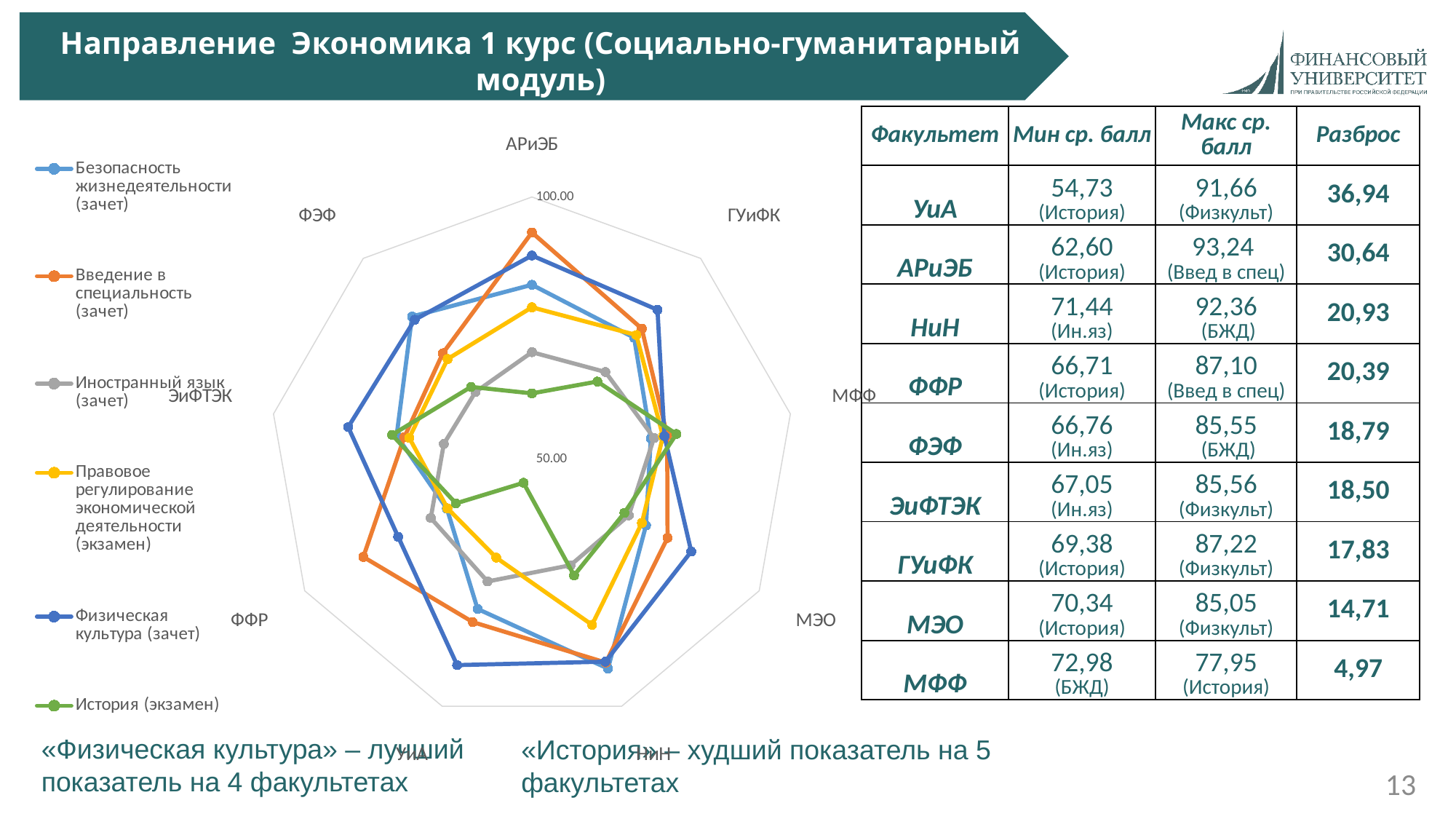
Which series has the lowest value for УиА? История (экзамен) How many faculty categories are plotted around the radar chart? 9 Which series has the lowest value for АРиЭБ? История (экзамен) Which series has the highest value for ЭиФТЭК? Физическая культура (зачет) What kind of chart is shown on the slide? Radar chart For МЭО, which is larger: Физическая культура (зачет) or История (экзамен)? Физическая культура (зачет) Which series has the highest value for УиА? Физическая культура (зачет) Which series has the lowest value for ЭиФТЭК? Иностранный язык (зачет) What colour is the line for История (экзамен) in the chart? Green How many series does the chart legend list? 6 Which series has the highest value for АРиЭБ? Введение в специальность (зачет) For ФФР, which is larger: Введение в специальность (зачет) or История (экзамен)? Введение в специальность (зачет)